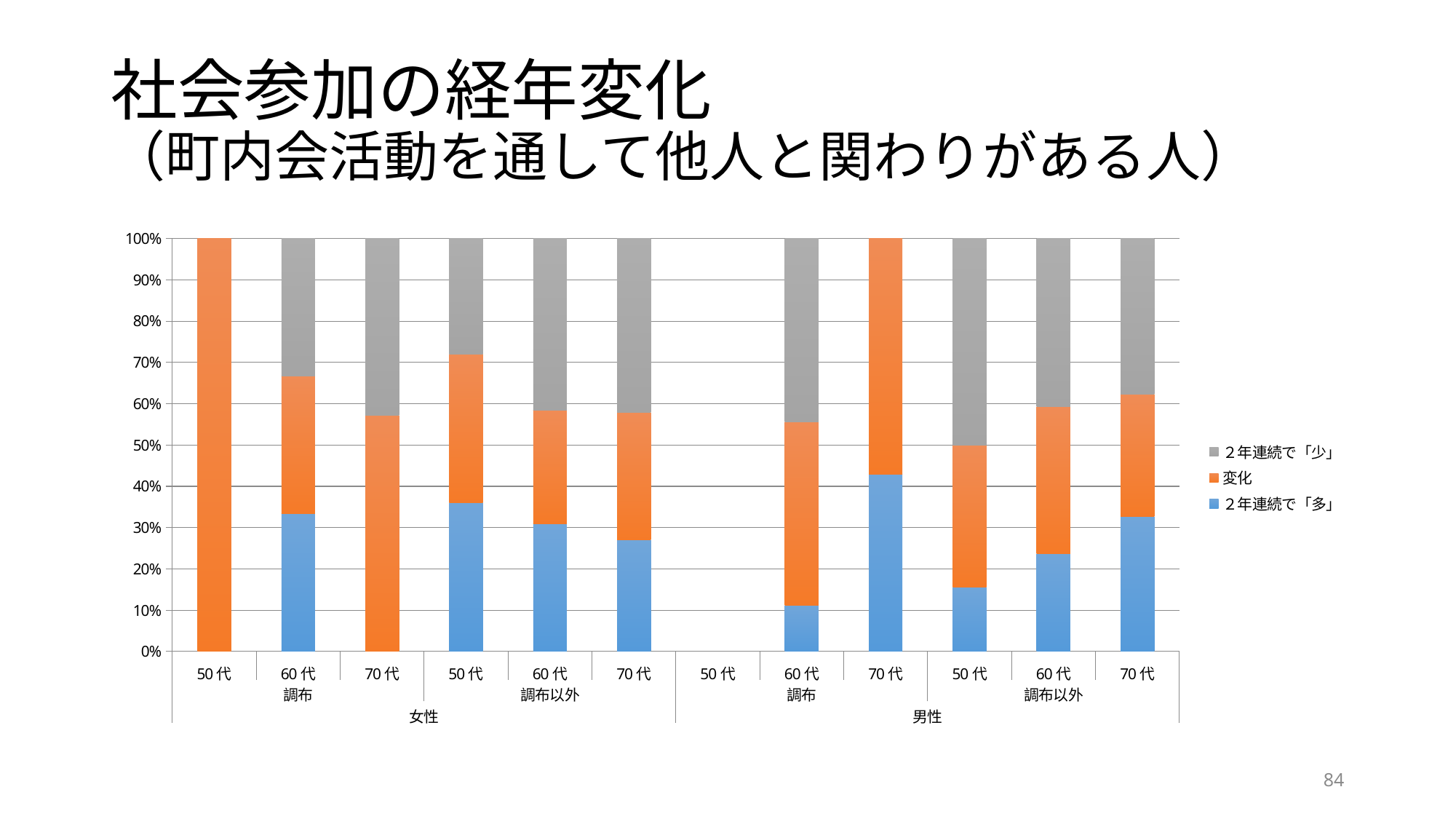
Is the share of 2年連続で「多」 for 男性 調布 70代 greater or less than 40%? greater Which category in the 男性 group has no bar drawn? 男性 調布 50代 How many category labels are shown along the x axis? 12 Which colour represents the series 変化 in the legend? orange Is the share of 2年連続で「多」 for 女性 調布以外 50代 greater or less than 30%? greater Is the share of 2年連続で「多」 for 男性 調布以外 50代 greater or less than 20%? less What share does 変化 take in the bar for 女性 調布 50代? 100% How many series does the legend list? 3 What kind of chart is shown on the slide? stacked bar chart Which category has the largest share of 2年連続で「多」 (blue)? 男性 調布 70代 Within the 男性 調布以外 group, does the share of 2年連続で「多」 rise or fall from 50代 to 70代? rise Which has the larger share of 2年連続で「多」: 女性 調布以外 50代 or 女性 調布以外 70代? 女性 調布以外 50代